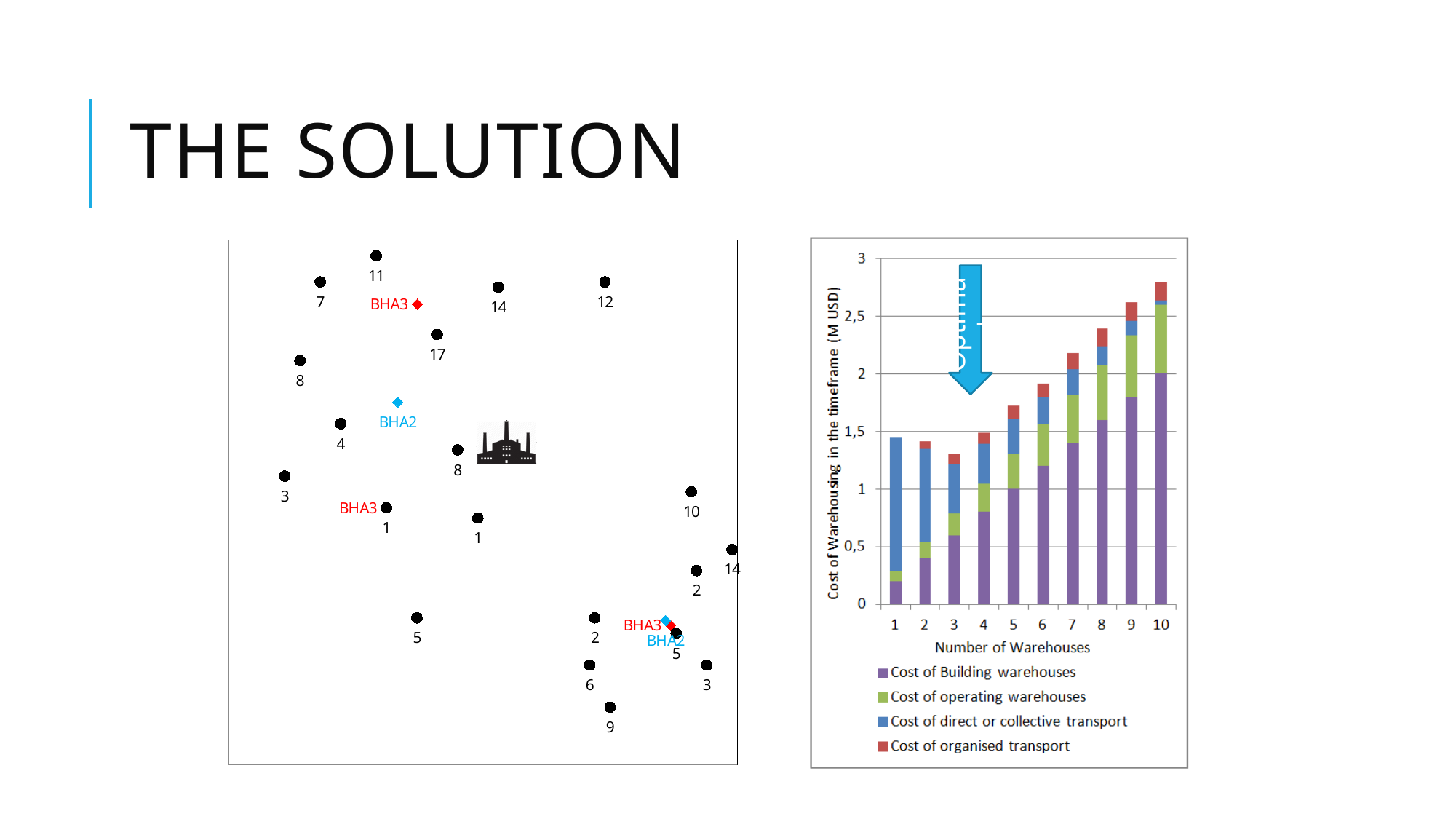
In the right-hand chart, is the total cost for 1 warehouse greater or less than 1? greater In the right-hand chart, how many numbers of warehouses are plotted along the x axis? 10 In the right-hand chart, which number of warehouses has the lowest total cost? 3 In the right-hand chart, how many series does the legend list? 4 What is the x-axis title of the right-hand chart? Number of Warehouses In the right-hand chart, is the cost of building warehouses for 3 warehouses greater or less than 0.5? greater In the right-hand chart, is the total cost for 10 warehouses greater or less than 2.5? greater In the right-hand chart, does the total cost rise or fall as the number of warehouses increases from 4 to 10? rise In the right-hand chart, which has the larger total cost: 10 warehouses or 1 warehouse? 10 warehouses In the right-hand chart, which number of warehouses has the highest total cost? 10 What kind of chart is shown on the right side of the slide? bar chart